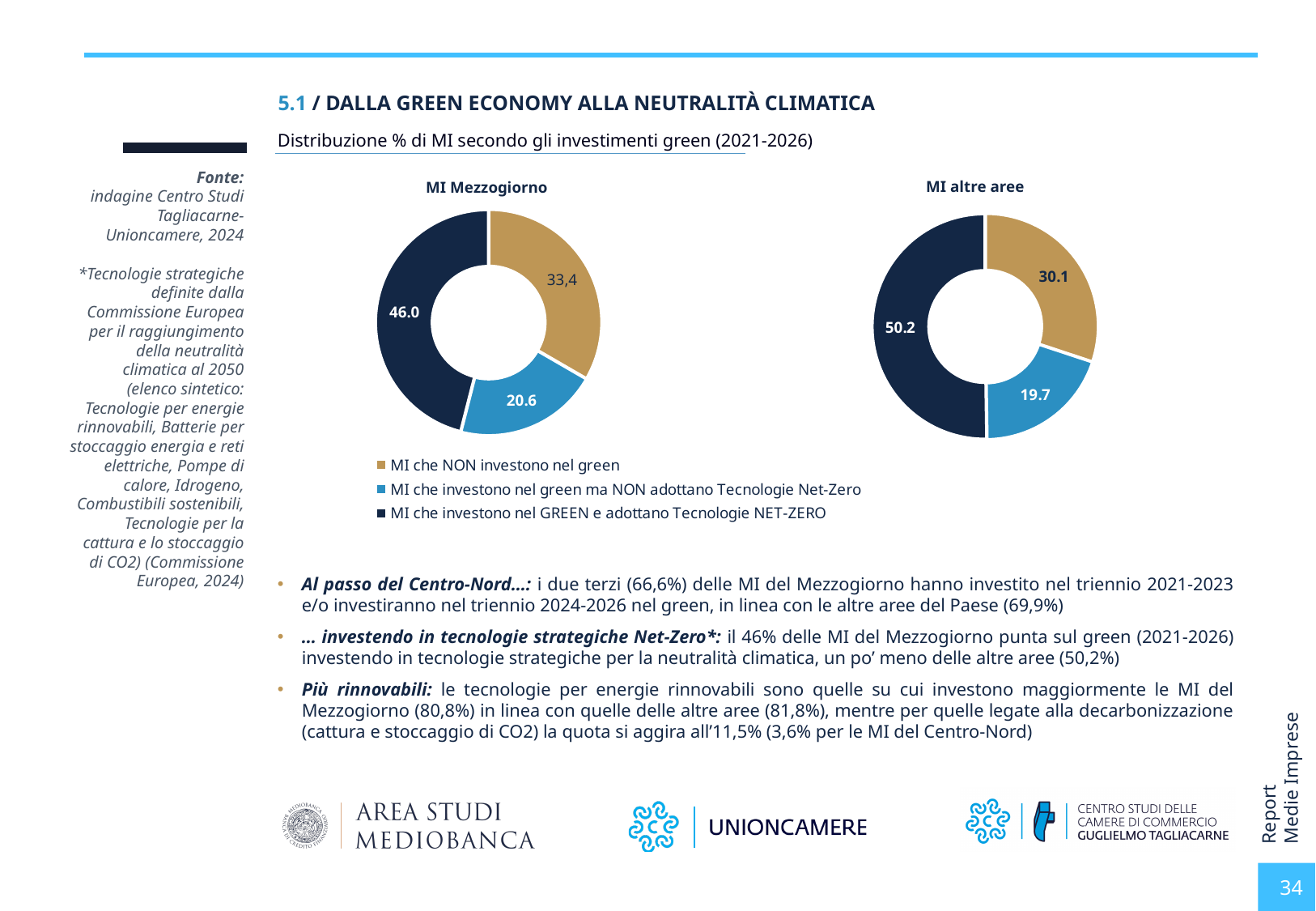
Which colour represents 'MI che NON investono nel green' in the charts? Gold/tan In the 'MI altre aree' chart, what is the difference between the value for 'MI che investono nel GREEN e adottano Tecnologie NET-ZERO' and the value for 'MI che NON investono nel green'? 20.1 In the 'MI Mezzogiorno' chart, which is larger: 'MI che NON investono nel green' or 'MI che investono nel green ma NON adottano Tecnologie Net-Zero'? MI che NON investono nel green How many categories does the 'MI Mezzogiorno' chart show? 3 In the 'MI Mezzogiorno' chart, what is the value for 'MI che NON investono nel green'? 33,4 In the 'MI Mezzogiorno' chart, what is the value for 'MI che investono nel GREEN e adottano Tecnologie NET-ZERO'? 46.0 What kind of chart is the 'MI altre aree' chart? Doughnut chart In the 'MI altre aree' chart, which category has the smallest share? MI che investono nel green ma NON adottano Tecnologie Net-Zero In the 'MI altre aree' chart, what is the value for 'MI che investono nel GREEN e adottano Tecnologie NET-ZERO'? 50.2 In the 'MI Mezzogiorno' chart, which category has the largest share? MI che investono nel GREEN e adottano Tecnologie NET-ZERO In the 'MI altre aree' chart, what is the value for 'MI che investono nel green ma NON adottano Tecnologie Net-Zero'? 19.7 Which chart shows a larger value for 'MI che investono nel GREEN e adottano Tecnologie NET-ZERO', 'MI Mezzogiorno' or 'MI altre aree'? MI altre aree